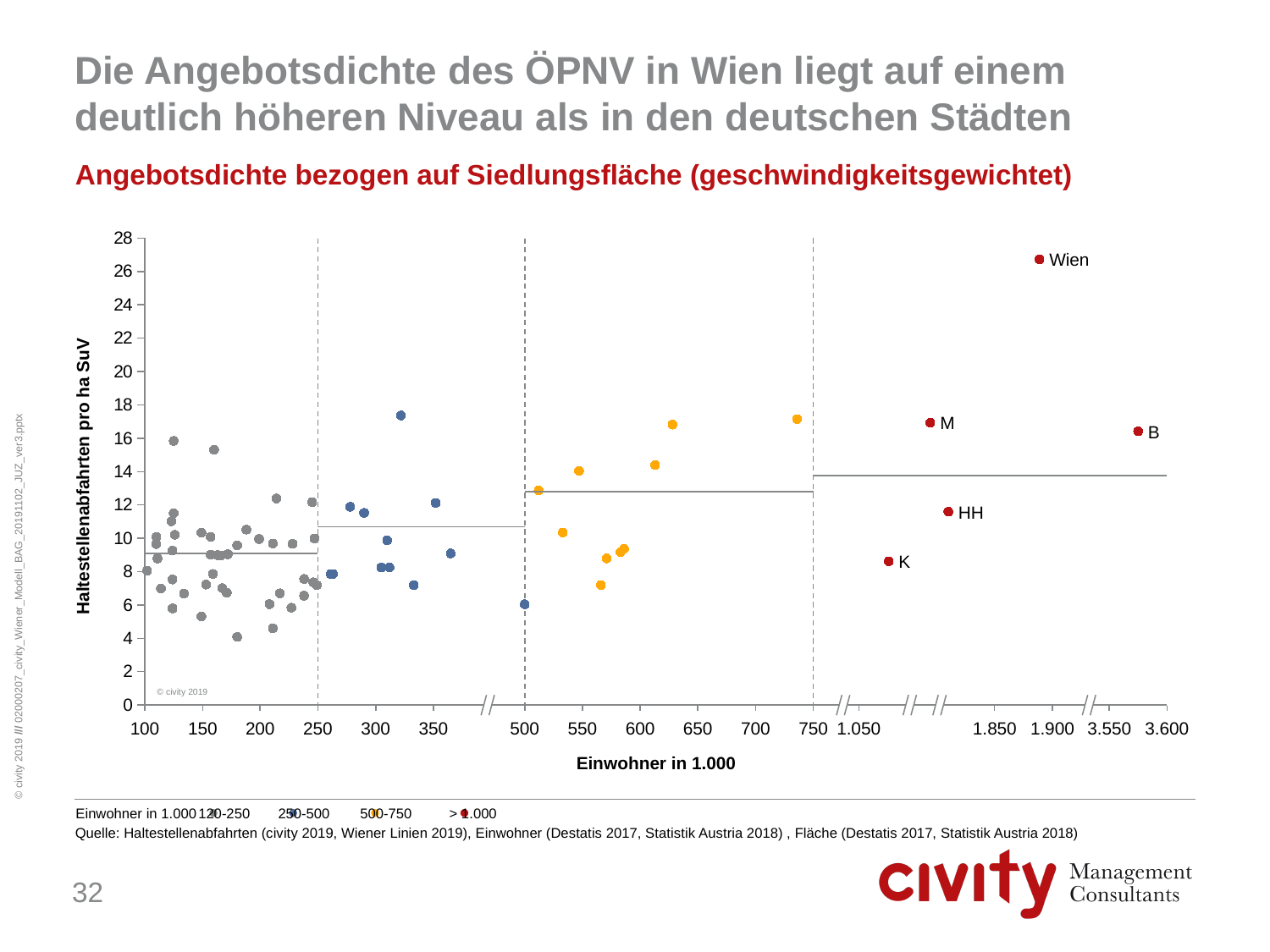
What kind of chart is shown on the slide? scatter chart Is the value for M greater or less than 14 Haltestellenabfahrten pro ha SuV? greater Which has the higher value, Wien or M? Wien Which has the higher value, HH or K? HH What is the label of the vertical axis of the chart? Haltestellenabfahrten pro ha SuV Which labelled city has the lowest value for Haltestellenabfahrten pro ha SuV? K Is the value for HH greater or less than 12 Haltestellenabfahrten pro ha SuV? less Is the value for Wien greater or less than 24 Haltestellenabfahrten pro ha SuV? greater How many population groups does the legend list? 4 Which labelled city has the highest value for Haltestellenabfahrten pro ha SuV? Wien How many red labelled points (cities with more than 1.000 thousand inhabitants) are shown in the chart? 5